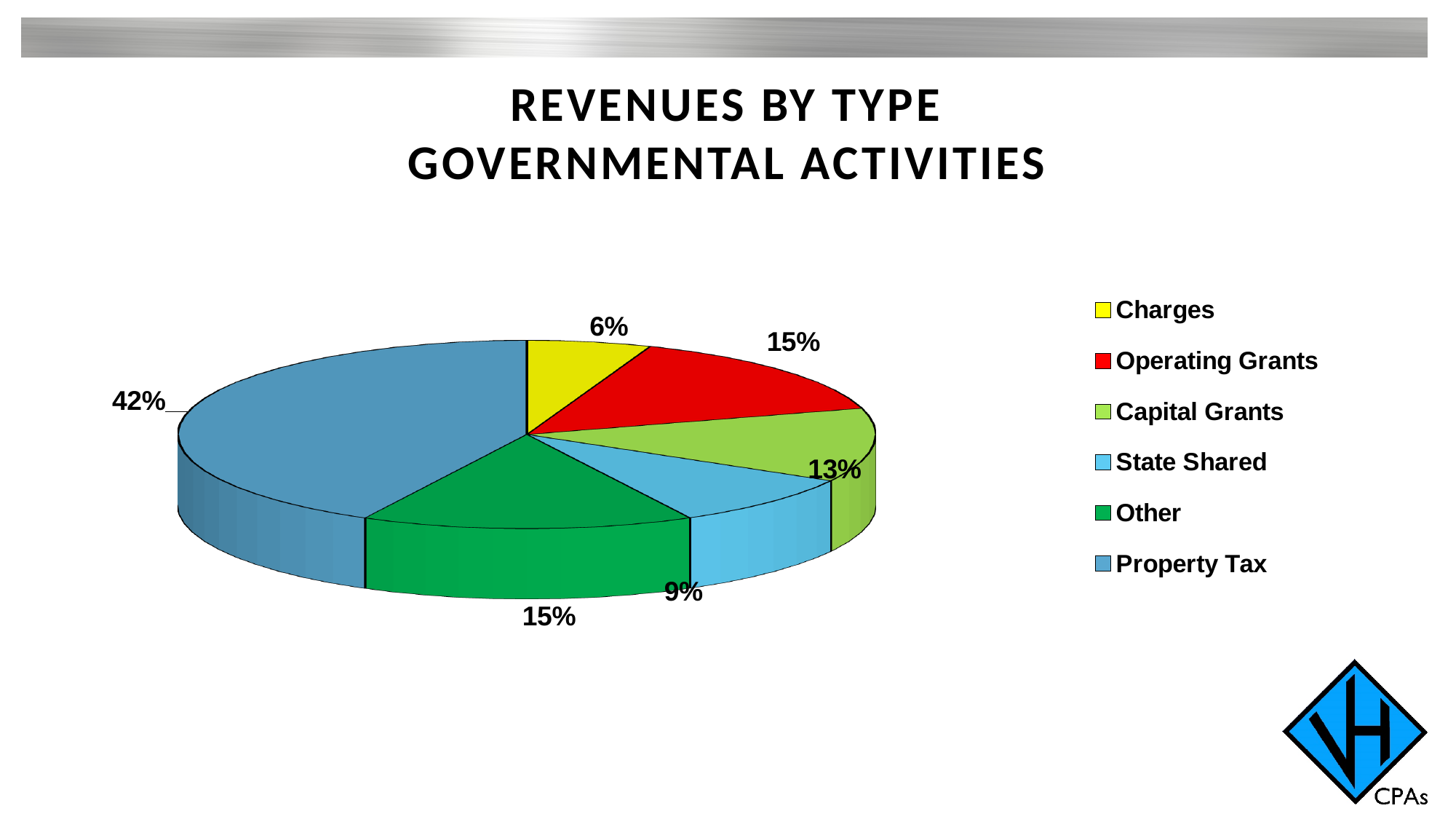
What share of revenues does Property Tax represent? 42% What is the share for State Shared revenues? 9% How many revenue types are shown in the pie chart? 6 How many percentage points larger is Property Tax than Capital Grants? 29 What percentage of revenues comes from Charges? 6% What colour is the Other slice in the pie chart? Green Which revenue type has the largest share of the pie? Property Tax Which is larger, the share for Capital Grants or the share for State Shared? Capital Grants What is the difference in percentage points between Operating Grants and State Shared? 6 What type of chart is shown on the slide? Pie chart What percentage is shown for Capital Grants? 13% Which revenue type has the smallest share of the pie? Charges